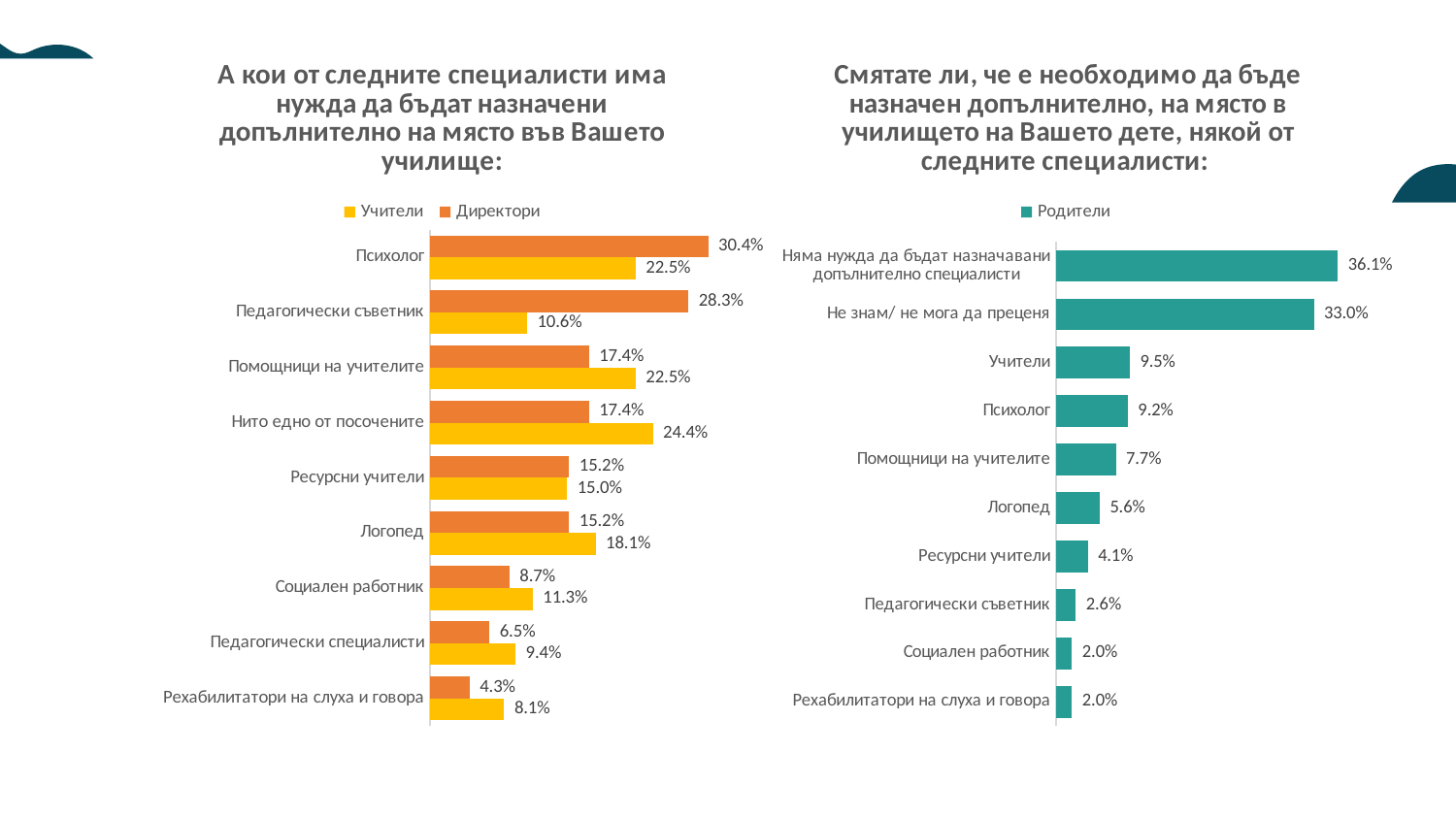
In the left chart, what is the value for Директори for Психолог? 30.4% In the left chart, which category has the highest value for Учители? Нито едно от посочените In the left chart, for Помощници на учителите, which series has the larger value, Учители or Директори? Учители In the right chart, what is the difference between the values for Учители and Психолог? 0.3% In the left chart, which category has the lowest value for Директори? Рехабилитатори на слуха и говора How many series does the legend of the left chart list? 2 In the right chart, which category has the highest value? Няма нужда да бъдат назначавани допълнително специалисти In the left chart, what is the value for Учители for Педагогически съветник? 10.6% In the left chart, what is the difference between the Директори and Учители values for Педагогически съветник? 17.7% How many categories are shown in the left chart? 9 In the right chart, what is the value for Не знам/ не мога да преценя? 33.0% What type of chart is the right chart? Bar chart